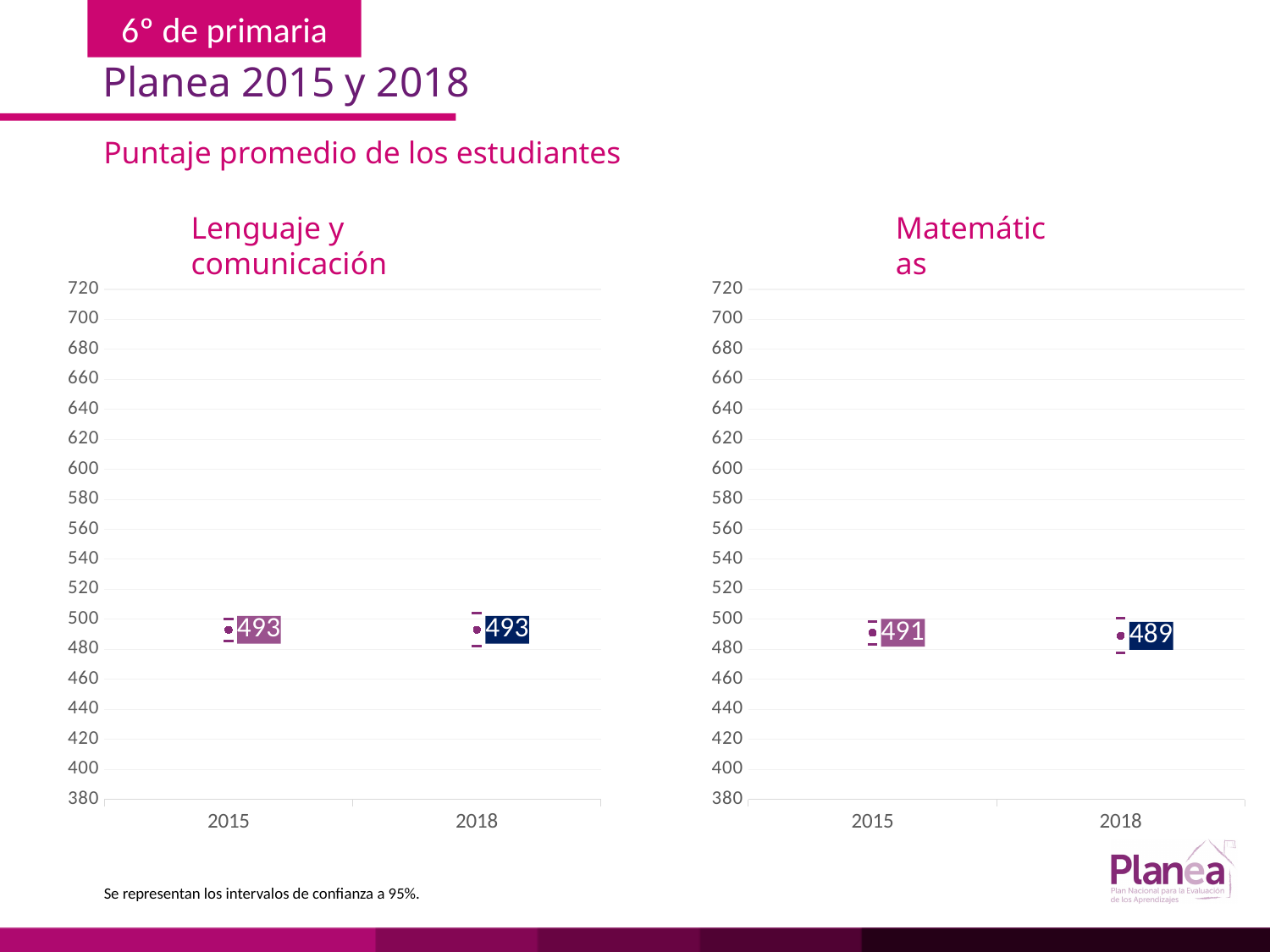
In the Matemáticas chart, what is the difference between the 2015 and 2018 scores? 2 According to the note at the bottom of the slide, what confidence level do the intervals represent? 95% What kind of chart is the Lenguaje y comunicación chart? Point chart with error bars In the Lenguaje y comunicación chart, what is the average score for 2015? 493 In the Lenguaje y comunicación chart, what is the average score for 2018? 493 In the Matemáticas chart, is the 2018 score greater or less than 500? less In the Matemáticas chart, what is the average score for 2015? 491 In the Lenguaje y comunicación chart, is the 2015 score greater or less than 480? greater In the Lenguaje y comunicación chart, what is the difference between the 2015 and 2018 scores? 0 How many years are plotted on the x axis of the Matemáticas chart? 2 What is the highest value shown on the y axis of the Matemáticas chart? 720 In the Matemáticas chart, what is the average score for 2018? 489